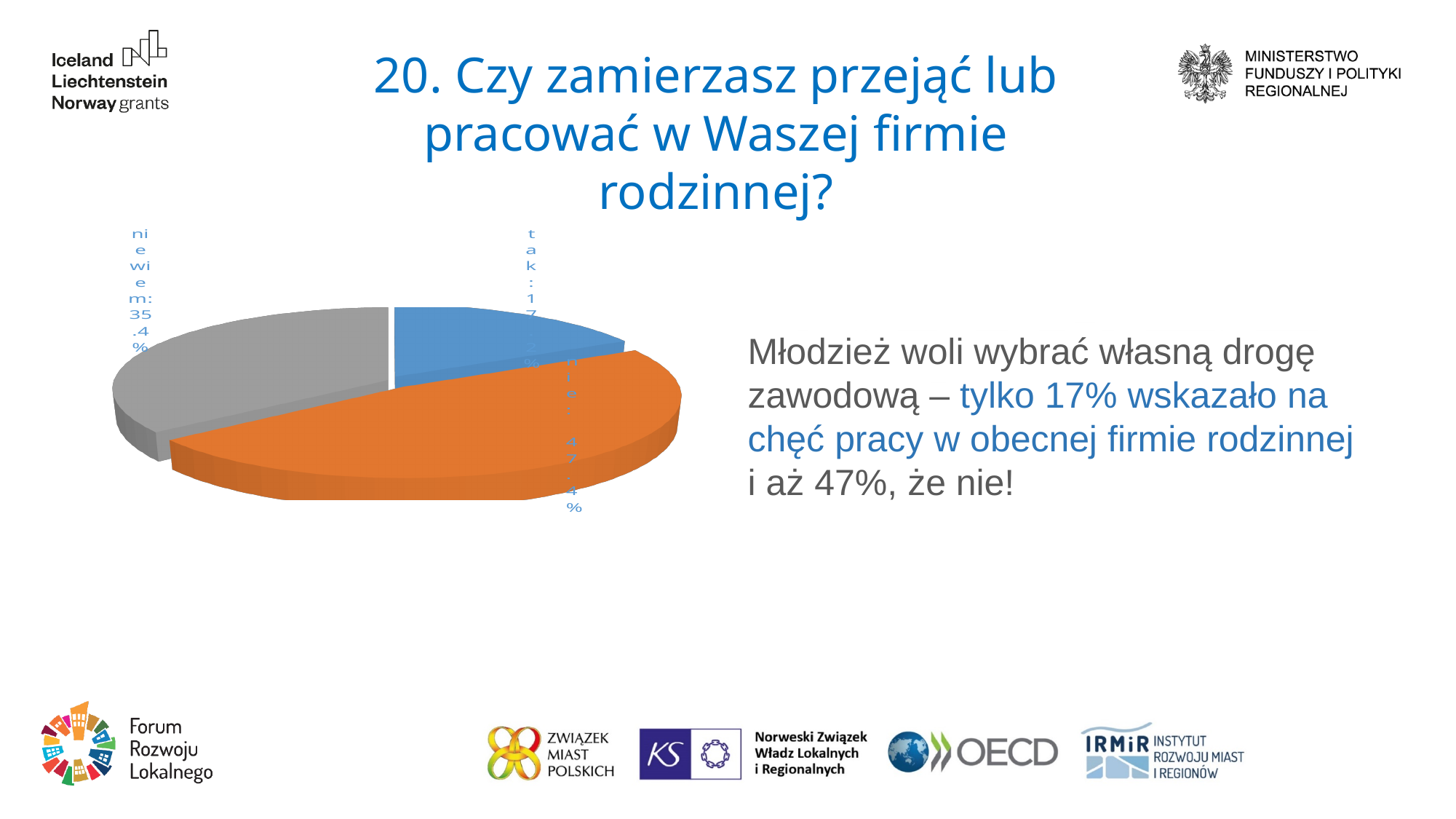
What colour is the "tak" slice of the pie chart? blue What is the difference in percentage points between the "nie" slice and the "tak" slice? 30.2 What percentage is shown for the "nie" slice? 47.4% What colour is the "nie" slice of the pie chart? orange What is the difference in percentage points between the "nie wiem" slice and the "tak" slice? 18.2 Which is larger, the "nie" slice or the "nie wiem" slice? nie What percentage is shown for the "tak" slice? 17.2% Which slice of the pie chart is the largest? nie What kind of chart is shown on the slide? pie chart What percentage is shown for the "nie wiem" slice? 35.4% How many slices does the pie chart have? 3 Which slice of the pie chart is the smallest? tak